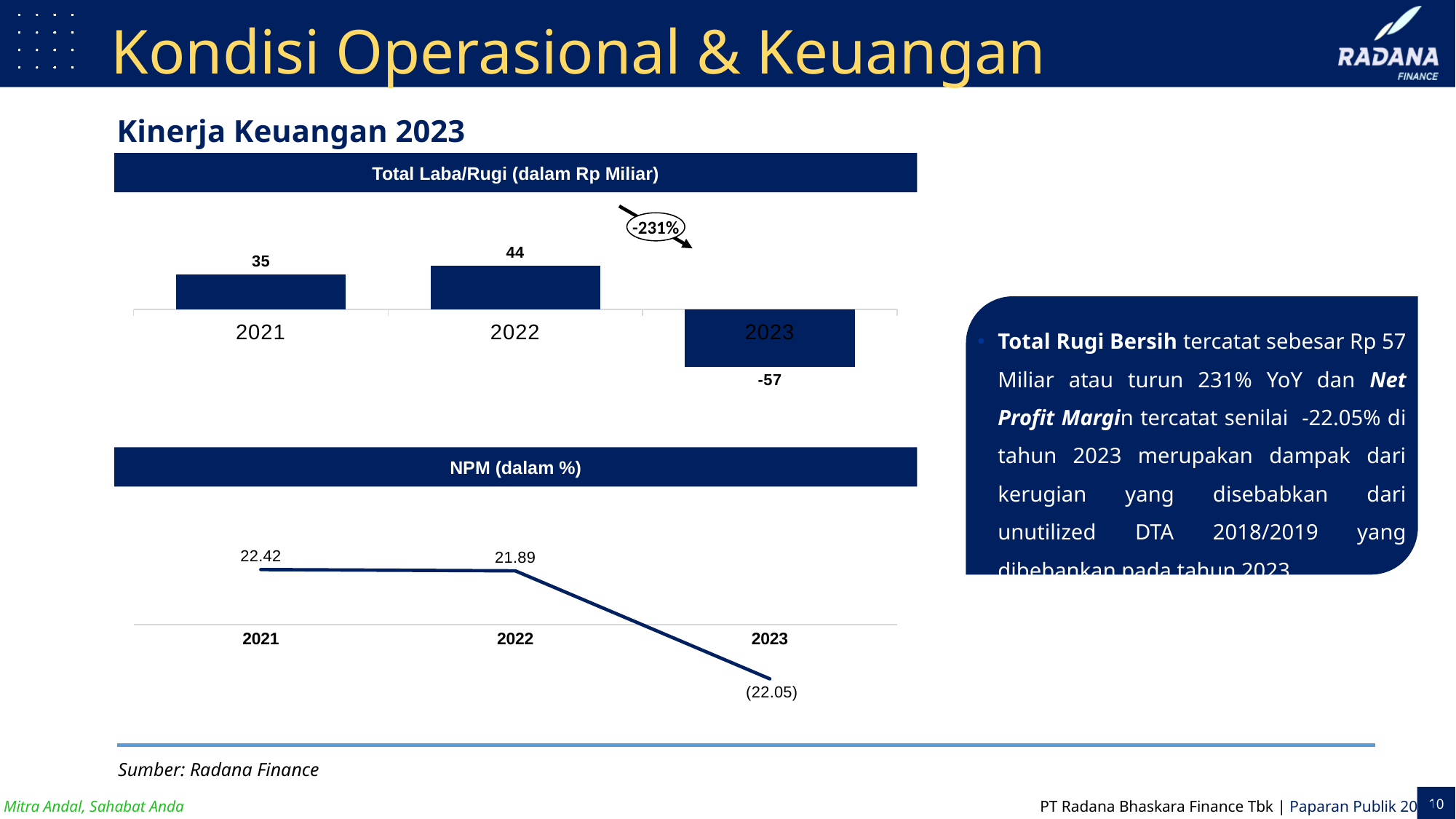
In the 'Total Laba/Rugi (dalam Rp Miliar)' chart, what is the value for 2023? -57 In the 'NPM (dalam %)' chart, how many data points are plotted? 3 In the 'NPM (dalam %)' chart, what is the value for 2021? 22.42 In the 'Total Laba/Rugi (dalam Rp Miliar)' chart, which year has the lowest value? 2023 In the 'Total Laba/Rugi (dalam Rp Miliar)' chart, what is the value for 2022? 44 In the 'NPM (dalam %)' chart, do the values rise or fall from 2021 to 2023? Fall What kind of chart is the 'NPM (dalam %)' chart? Line chart What kind of chart is the 'Total Laba/Rugi (dalam Rp Miliar)' chart? Bar chart In the 'NPM (dalam %)' chart, what is the value for 2023? (22.05) In the 'Total Laba/Rugi (dalam Rp Miliar)' chart, which year has the highest value? 2022 In the 'Total Laba/Rugi (dalam Rp Miliar)' chart, what is the difference between the 2022 and 2021 values? 9 In the 'NPM (dalam %)' chart, which is larger, the value for 2021 or 2022? 2021